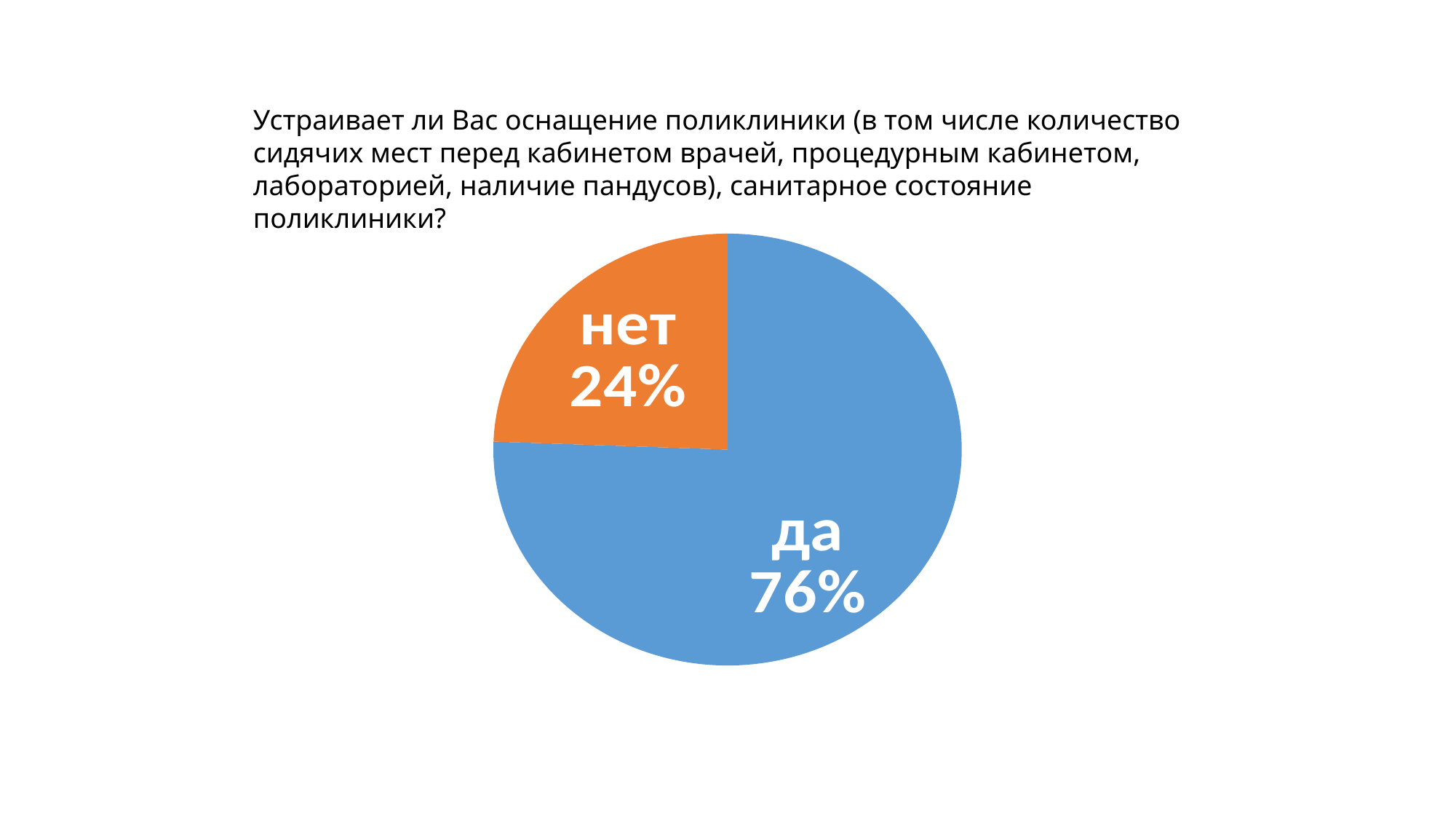
What colour is the "да" slice? blue How many slices does the pie chart have? 2 Which is larger, the "да" slice or the "нет" slice? да What is the difference in percentage points between the "да" and "нет" slices? 52 What share of the pie is labelled "да"? 76% What share of the pie is labelled "нет"? 24% What colour is the "нет" slice? orange What is the total of the two slice percentages shown? 100% What kind of chart is shown on the slide? pie chart Which slice of the pie is the largest? да Which slice of the pie is the smallest? нет